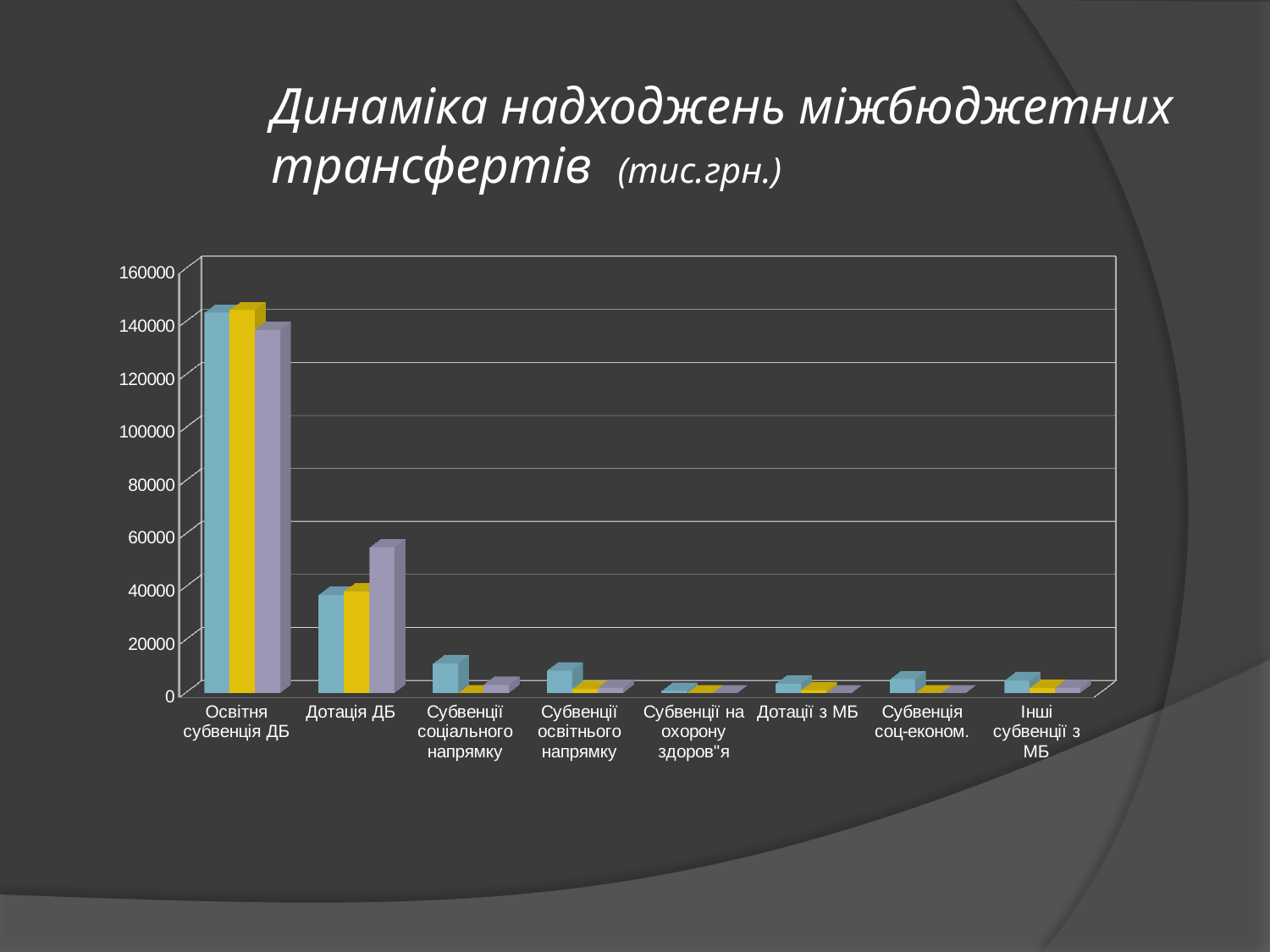
Is the value of the first (blue) bar for Дотація ДБ greater or less than 60000? less What kind of chart is shown on the slide? bar chart Is the value of the first (blue) bar for Субвенції соціального напрямку greater or less than 20000? less Which category has larger values: Освітня субвенція ДБ or Дотація ДБ? Освітня субвенція ДБ Which category has the lowest bars in the chart? Субвенції на охорону здоров"я Is the value of the first (blue) bar for Освітня субвенція ДБ greater or less than 120000? greater Which category has the highest bars in the chart? Освітня субвенція ДБ How many categories are shown on the x axis of the chart? 8 What is the title of the chart on the slide? Динаміка надходжень міжбюджетних трансфертів (тис.грн.) What is the highest value shown on the vertical axis of the chart? 160000 Which category has larger values: Дотація ДБ or Субвенції соціального напрямку? Дотація ДБ